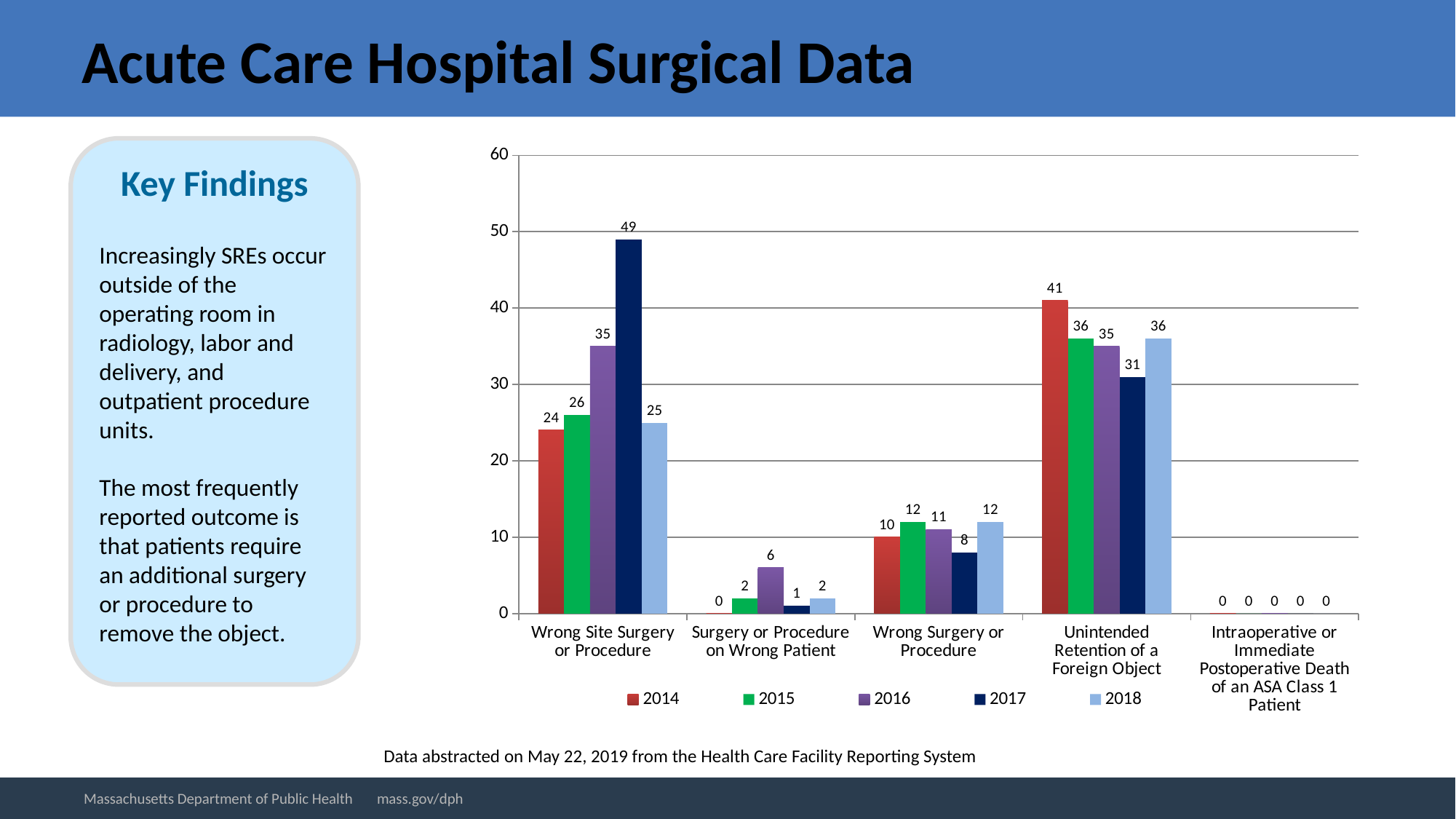
What is the value for 2016 in the Surgery or Procedure on Wrong Patient category? 6 How many series does the legend list? 5 Which year has the highest value in the Wrong Site Surgery or Procedure category? 2017 Which year has the lowest value in the Unintended Retention of a Foreign Object category? 2017 Which is larger in the Wrong Surgery or Procedure category: the 2015 value or the 2017 value? 2015 What is the value for 2018 in the Intraoperative or Immediate Postoperative Death of an ASA Class 1 Patient category? 0 What kind of chart is shown on the slide? bar chart What is the value for 2017 in the Wrong Site Surgery or Procedure category? 49 What is the value for 2014 in the Unintended Retention of a Foreign Object category? 41 How many categories are shown on the x axis? 5 What is the difference between the 2017 and 2014 values in the Wrong Site Surgery or Procedure category? 25 Is the value for 2016 in the Unintended Retention of a Foreign Object category greater or less than 30? greater